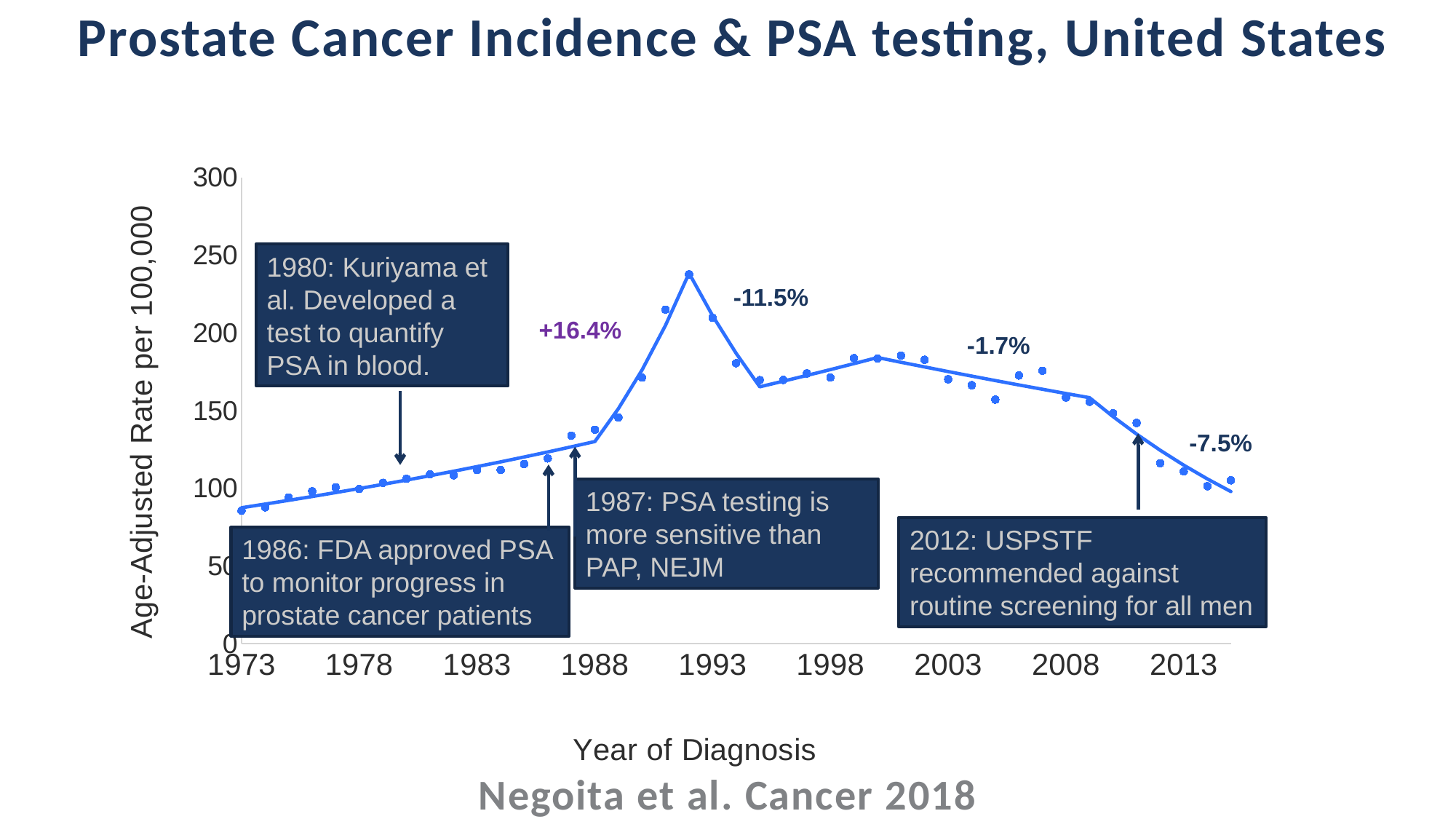
Is the age-adjusted rate at the 1992 peak greater or less than 200? greater What annual percent change is annotated for the segment after 2012? -7.5% Is the age-adjusted rate for 2003 greater or less than 150? greater What is the title of the chart? Prostate Cancer Incidence & PSA testing, United States What annual percent change is annotated for the segment between 1987 and 1992? +16.4% Does the age-adjusted rate rise or fall between 1973 and 1992? Rise Which year has the lowest age-adjusted rate on the chart? 1973 Is the age-adjusted rate for 2013 greater or less than 150? less Around which year does the age-adjusted rate reach its highest point? 1992 What is the label of the y axis? Age-Adjusted Rate per 100,000 What kind of chart is shown on the slide? Line chart